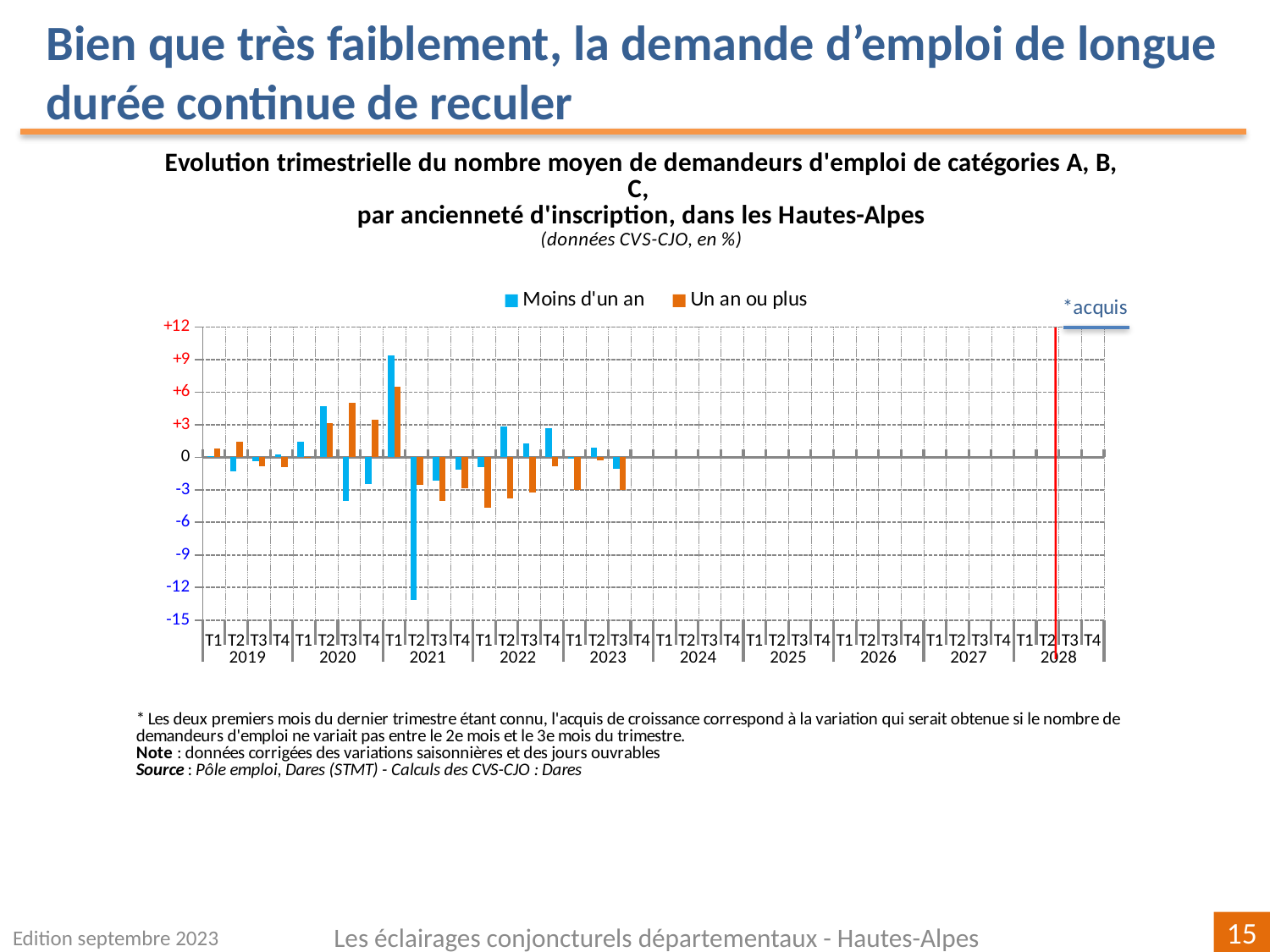
What kind of chart is shown on the slide? bar chart How many series does the legend list? 2 Is the 'Moins d'un an' value for T1 2021 greater or less than +6? greater Is the 'Moins d'un an' value for T2 2021 greater or less than -12? less What are the two series named in the legend? Moins d'un an; Un an ou plus In T2 2021, which series has the larger value, 'Moins d'un an' or 'Un an ou plus'? Un an ou plus Is the 'Un an ou plus' value for T3 2020 greater or less than +3? greater How many years are labelled along the x axis? 10 Which quarter has the highest value for the 'Un an ou plus' series? T1 2021 Which quarter has the highest value for the 'Moins d'un an' series? T1 2021 Which quarter has the lowest value for the 'Moins d'un an' series? T2 2021